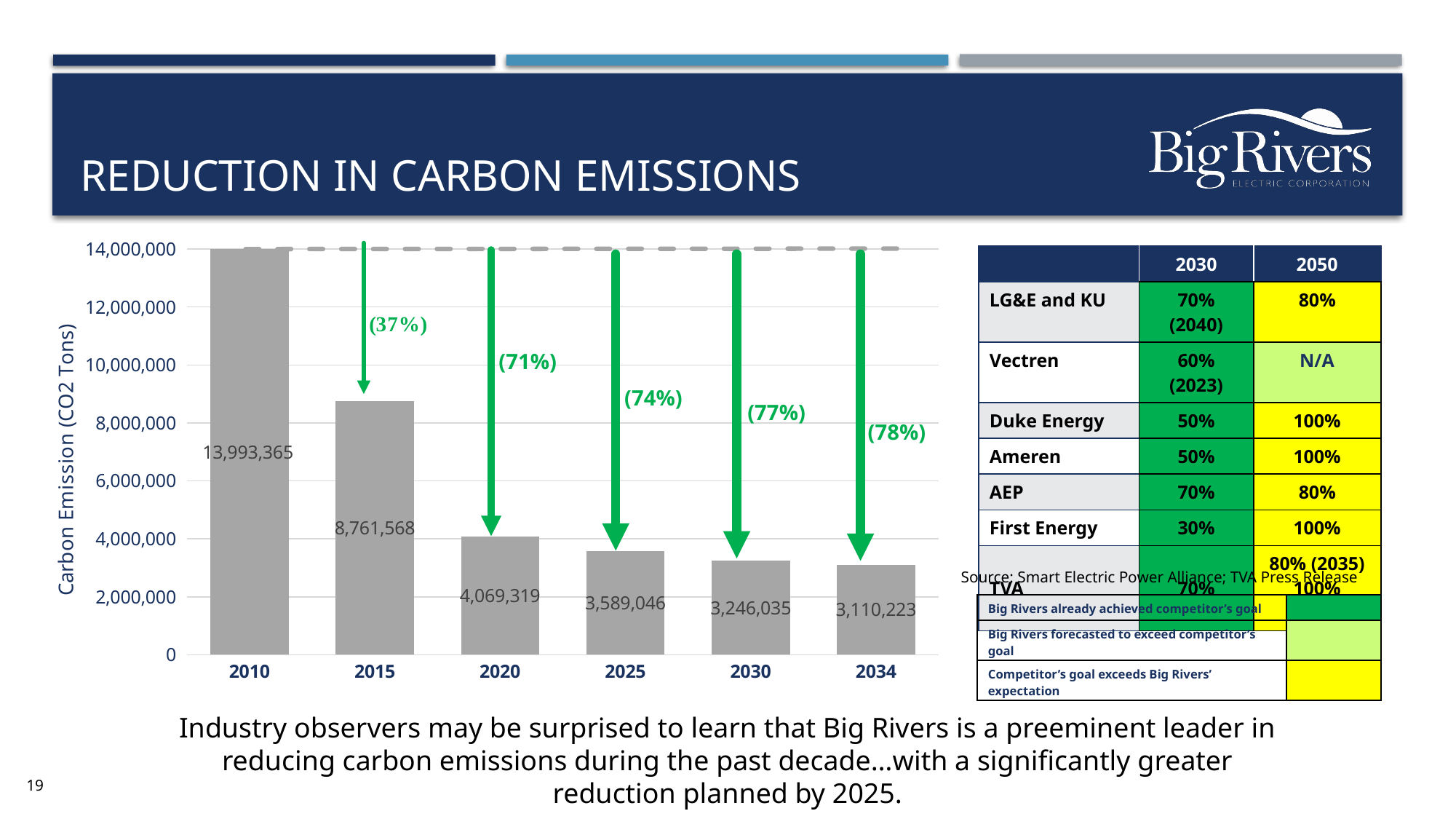
Which year has the lowest carbon emission value in the chart? 2034 What is the carbon emission value shown for 2010? 13,993,365 What is the carbon emission value shown for 2025? 3,589,046 What kind of chart is used to show carbon emissions? Bar chart Which year has the highest carbon emission value in the chart? 2010 Which year has a larger carbon emission value, 2015 or 2020? 2015 What is the difference between the carbon emission values for 2020 and 2025? 480,273 Is the carbon emission value for 2015 greater or less than 8,000,000? greater What percentage reduction is labelled above the 2030 bar? (77%) What is the carbon emission value shown for 2034? 3,110,223 How many years are shown on the x axis of the chart? 6 What is the difference between the carbon emission values for 2010 and 2015? 5,231,797